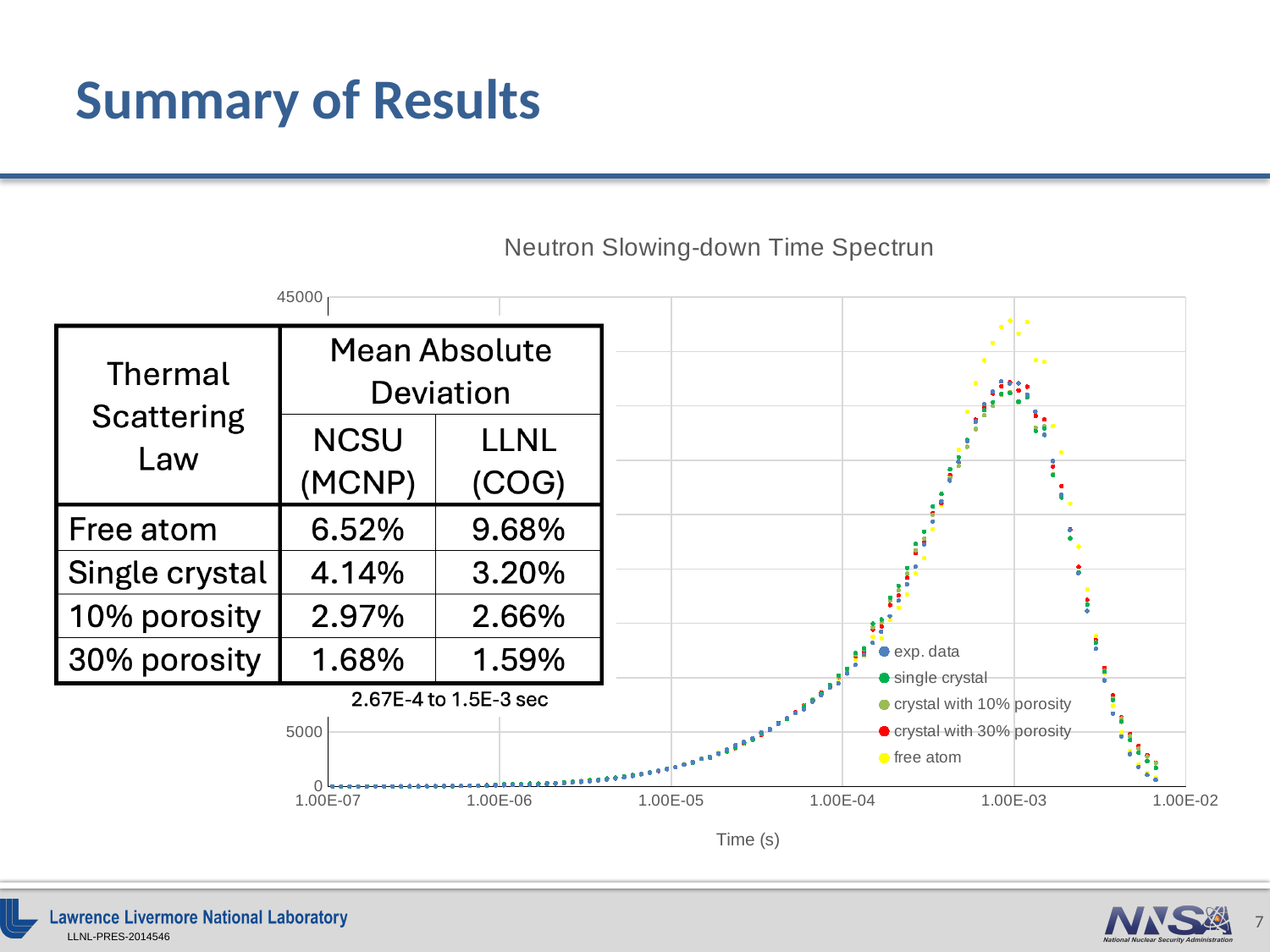
What is the highest value shown on the y axis of the chart? 45000 Is the peak value of the exp. data series greater or less than 40000? less How many series does the chart legend list? 5 How do the values change along the x axis in the chart? rise to a peak then fall What is the title of the chart? Neutron Slowing-down Time Spectrun Is the peak of the free atom series greater or less than 45000? less Which series reaches the highest peak value in the chart? free atom Is the value of the exp. data series at 1.00E-06 s greater or less than 5000? less What type of chart is shown on the slide? scatter chart Near which x-axis tick do the series reach their peak? 1.00E-03 What is the label of the x axis of the chart? Time (s)